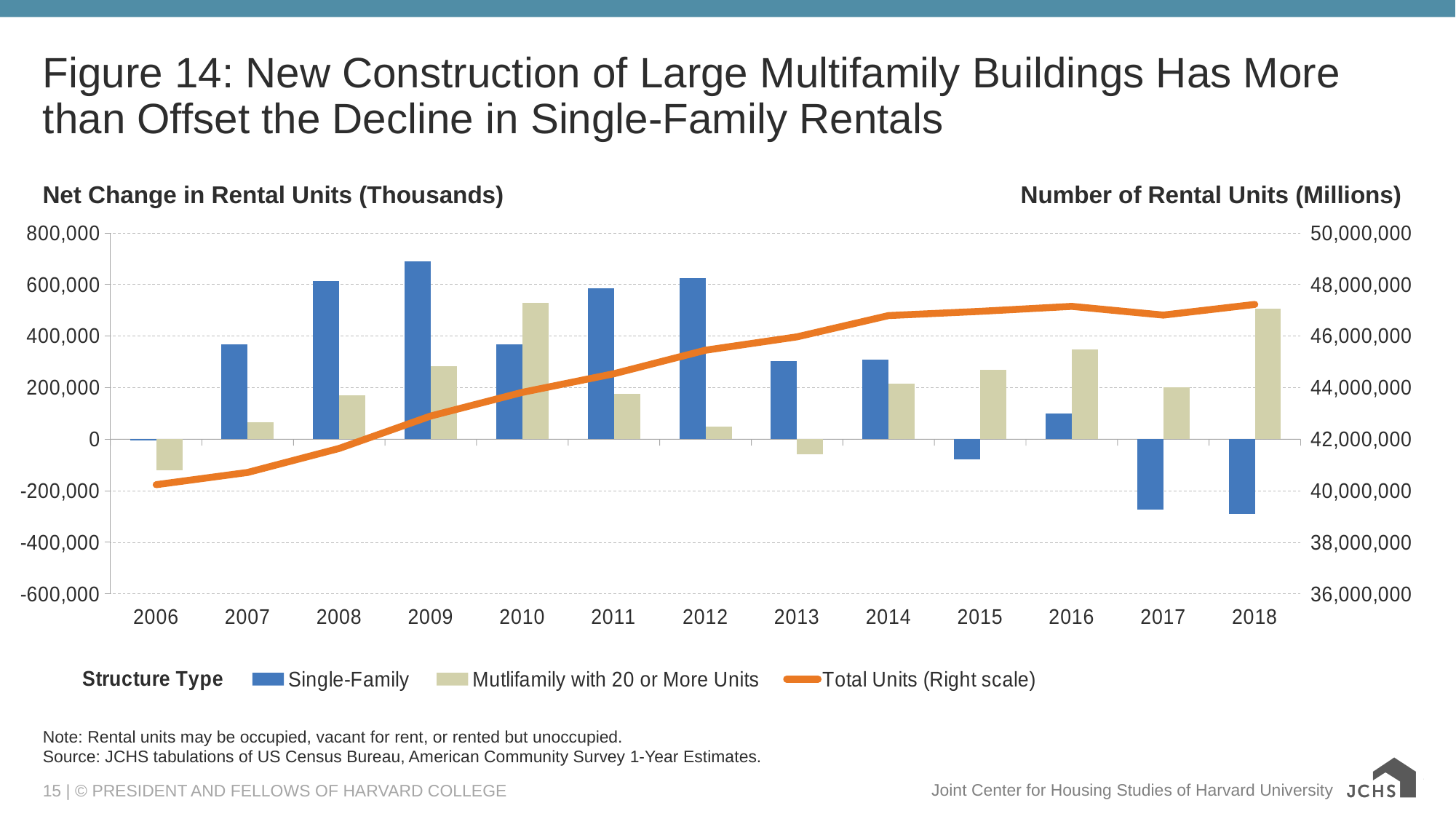
In which year is the Single-Family net change the highest? 2009 In which year is the Multifamily with 20 or More Units net change the lowest? 2006 How many years are shown on the x axis of the chart? 13 Is the Single-Family value for 2017 greater or less than -200,000? less Is the Total Units (Right scale) value for 2018 greater or less than 46,000,000? greater Does the Total Units (Right scale) line generally rise or fall from 2006 to 2018? rise Is the Multifamily with 20 or More Units value for 2010 greater or less than 400,000? greater How many series does the chart's legend list? 3 What kind of chart is shown on the slide? Combination bar and line chart In 2018, which is larger: the Single-Family net change or the Multifamily with 20 or More Units net change? Multifamily with 20 or More Units In 2012, which is larger: the Single-Family net change or the Multifamily with 20 or More Units net change? Single-Family